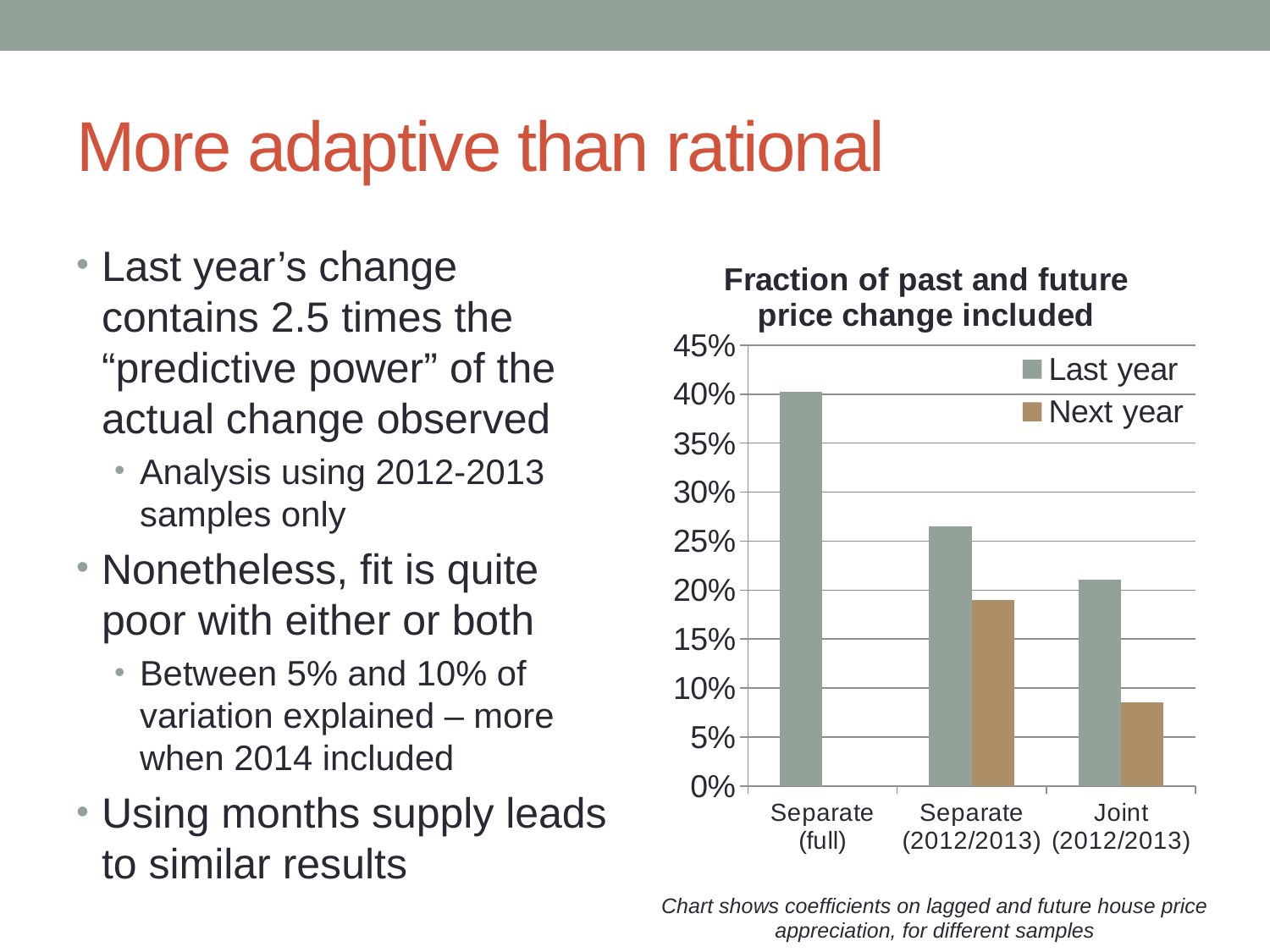
Is the Next year value for Joint (2012/2013) greater or less than 10%? less What is the title of the chart? Fraction of past and future price change included Is the Last year value for Separate (full) greater or less than 35%? greater Which category has the lowest value for the Last year series? Joint (2012/2013) Do the Last year values rise or fall moving from left to right across the categories? Fall Which category has the highest value for the Last year series? Separate (full) What kind of chart is shown on the slide? Bar chart Is the Next year value for Separate (2012/2013) greater or less than 15%? greater How many categories are shown on the x axis of the chart? 3 How many series does the chart's legend list? 2 For Joint (2012/2013), which series has the larger value, Last year or Next year? Last year